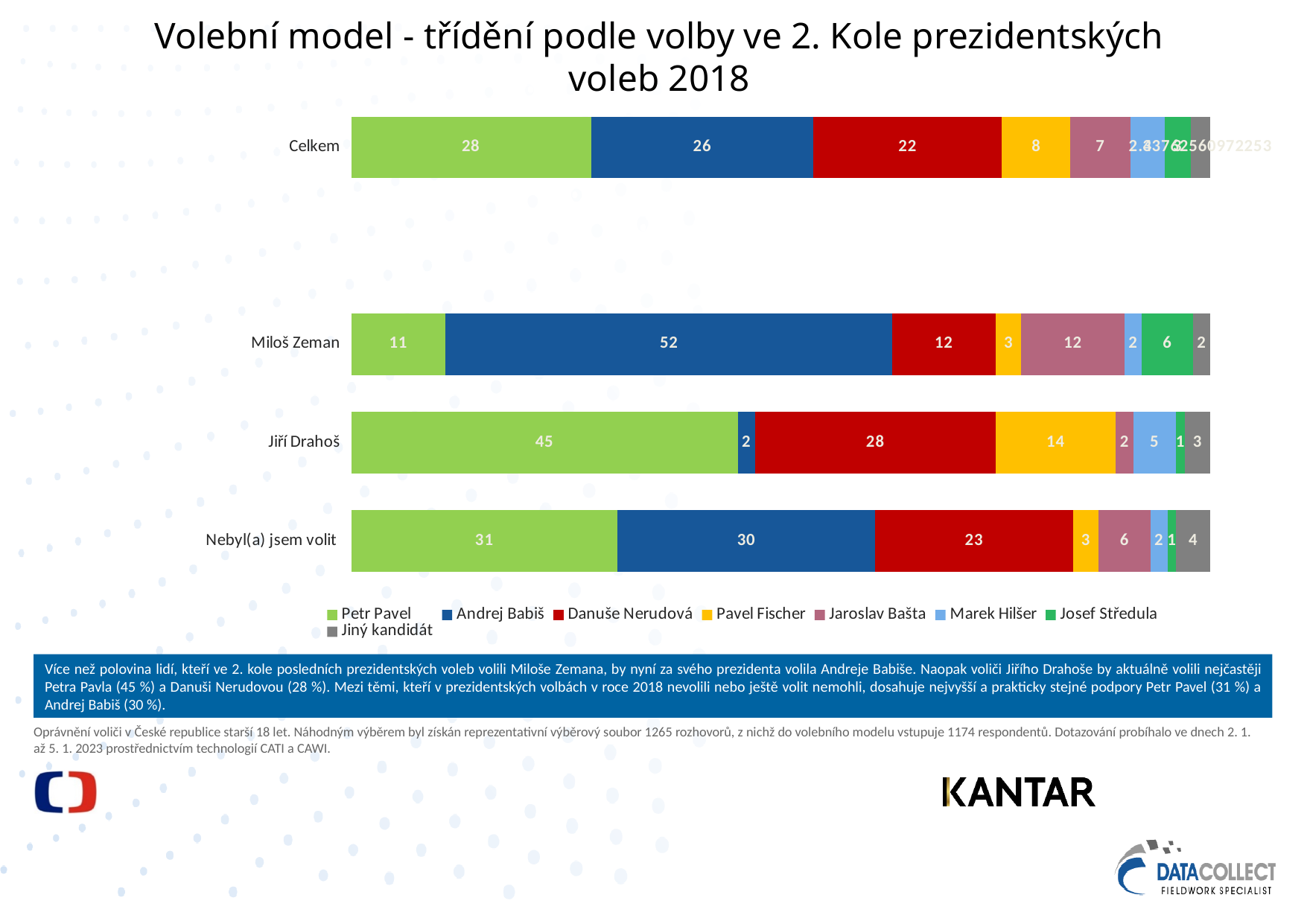
What is the value for Petr Pavel among Jiří Drahoš voters? 45 Which is larger in the Celkem row: Petr Pavel or Andrej Babiš? Petr Pavel How many categories (rows) are plotted in the chart? 4 What kind of chart is shown on the slide? stacked bar chart What is the value for Danuše Nerudová in the Celkem row? 22 What is the total of the stacked bar for Miloš Zeman? 100 What is the value for Pavel Fischer among Jiří Drahoš voters? 14 Which candidate has the lowest value in the Jiří Drahoš row? Josef Středula Which candidate has the highest value in the Nebyl(a) jsem volit row? Petr Pavel How many series does the legend list? 8 What is the value for Andrej Babiš among Miloš Zeman voters? 52 What is the difference between Petr Pavel and Danuše Nerudová among Jiří Drahoš voters? 17